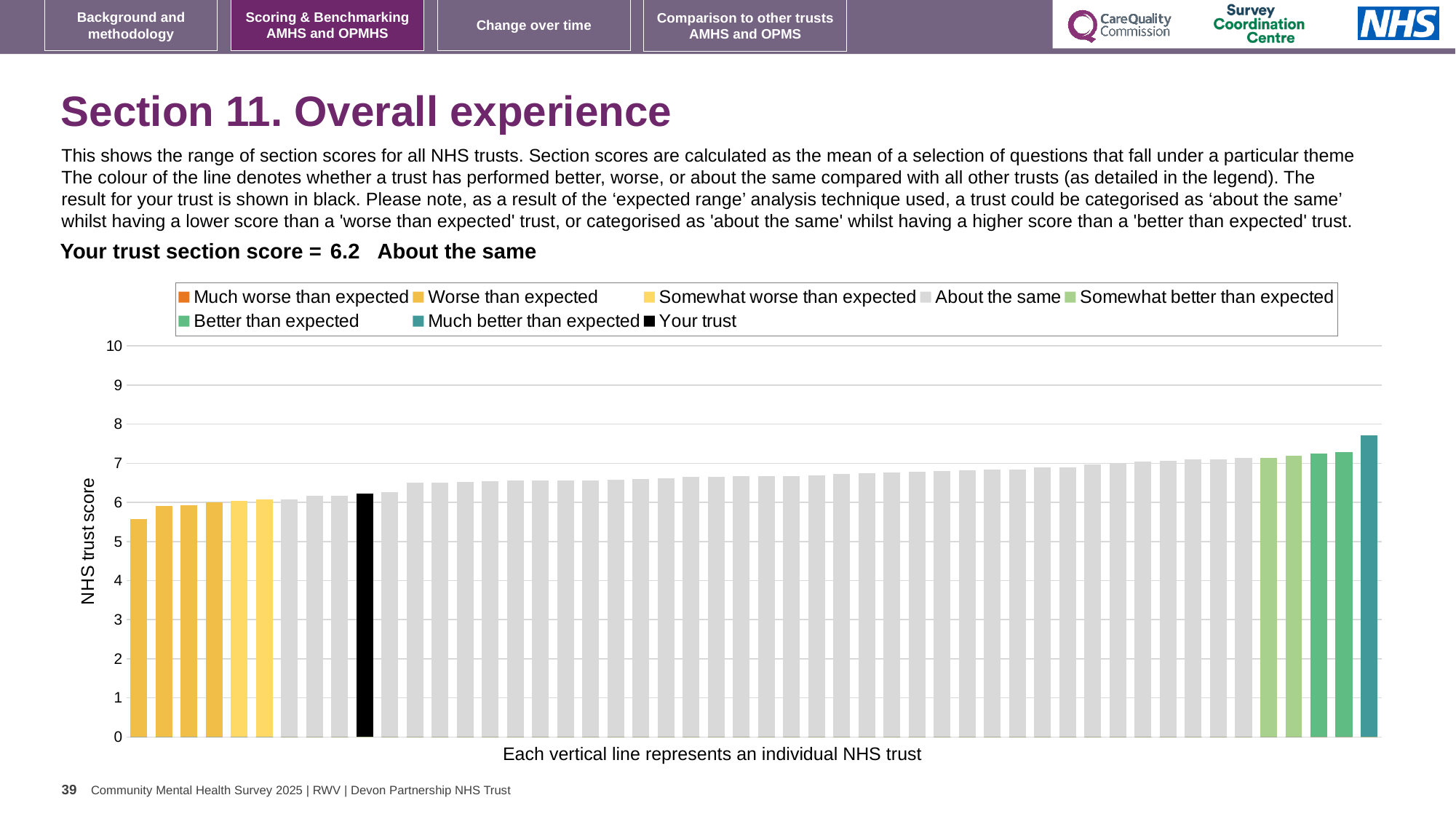
Is the value of the lowest bar greater or less than 6? less Which legend category does the highest bar belong to? Much better than expected What kind of chart is shown on the slide? bar chart What is the section score for your trust shown on the slide? 6.2 Do the bar values rise or fall from left to right along the x axis? rise What is the label on the vertical axis of the chart? NHS trust score How many bars are coloured as 'Much better than expected'? 1 Which category is your trust placed in according to the slide? About the same Is the value of the highest bar greater or less than 7? greater Is the value of the black 'Your trust' bar greater or less than 5? greater How many entries does the chart legend list? 8